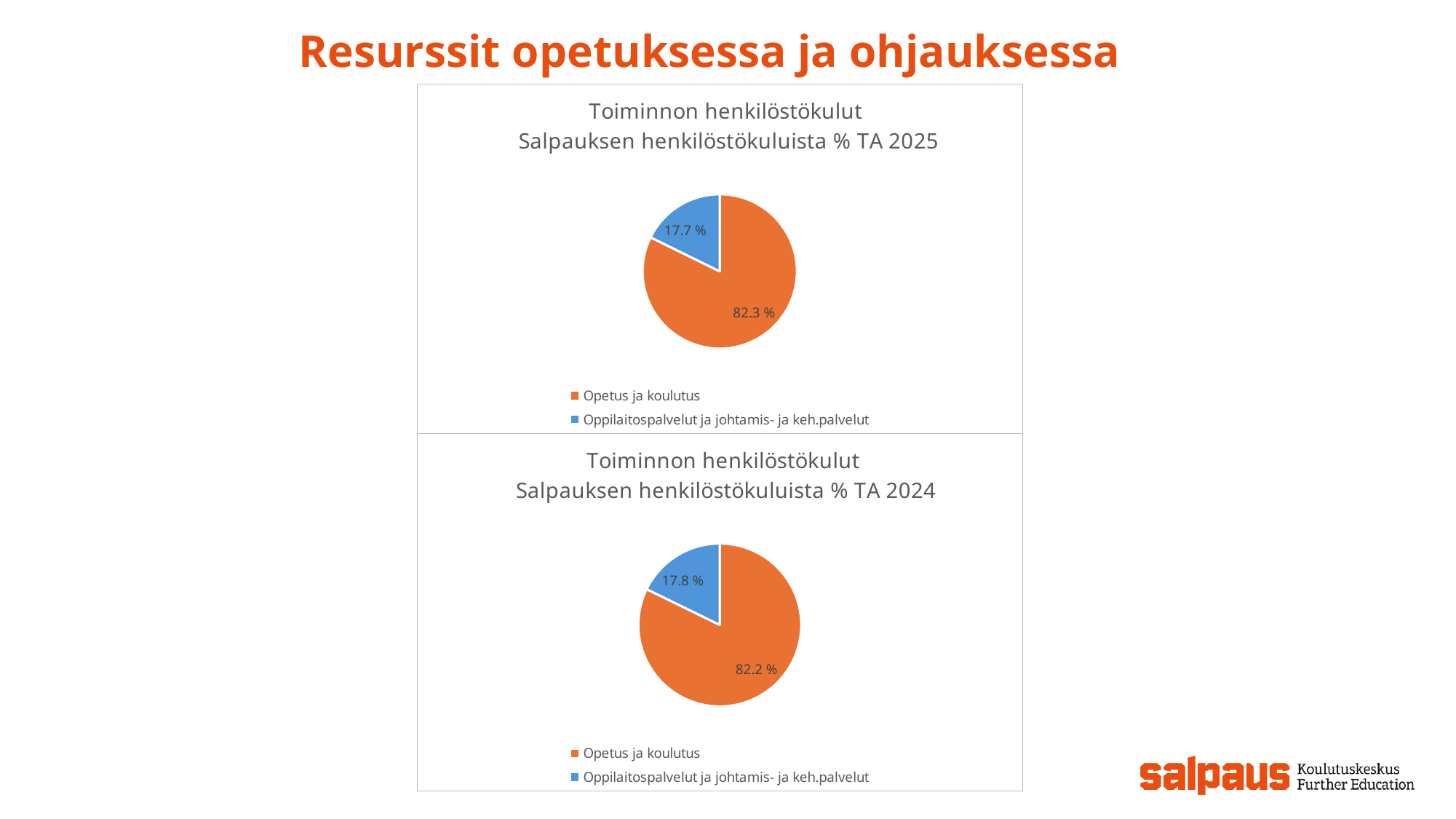
In the top chart (TA 2025), what is the difference in percentage points between Opetus ja koulutus and Oppilaitospalvelut ja johtamis- ja keh.palvelut? 64.6 In the top chart (TA 2025), what share does Oppilaitospalvelut ja johtamis- ja keh.palvelut have? 17.7 % In the top chart (TA 2025), which category has the largest slice? Opetus ja koulutus In the bottom chart (TA 2024), what share does Oppilaitospalvelut ja johtamis- ja keh.palvelut have? 17.8 % How many entries does the legend of the top chart (TA 2025) list? 2 How many slices does the bottom chart (TA 2024) have? 2 In the bottom chart (TA 2024), what share does Opetus ja koulutus have? 82.2 % In the top chart (TA 2025), what share does Opetus ja koulutus have? 82.3 % In the bottom chart (TA 2024), which category has the smallest slice? Oppilaitospalvelut ja johtamis- ja keh.palvelut In the bottom chart (TA 2024), what is the difference in percentage points between Opetus ja koulutus and Oppilaitospalvelut ja johtamis- ja keh.palvelut? 64.4 What is the title of the bottom chart? Toiminnon henkilöstökulut Salpauksen henkilöstökuluista % TA 2024 What type of chart is the top chart (TA 2025)? Pie chart